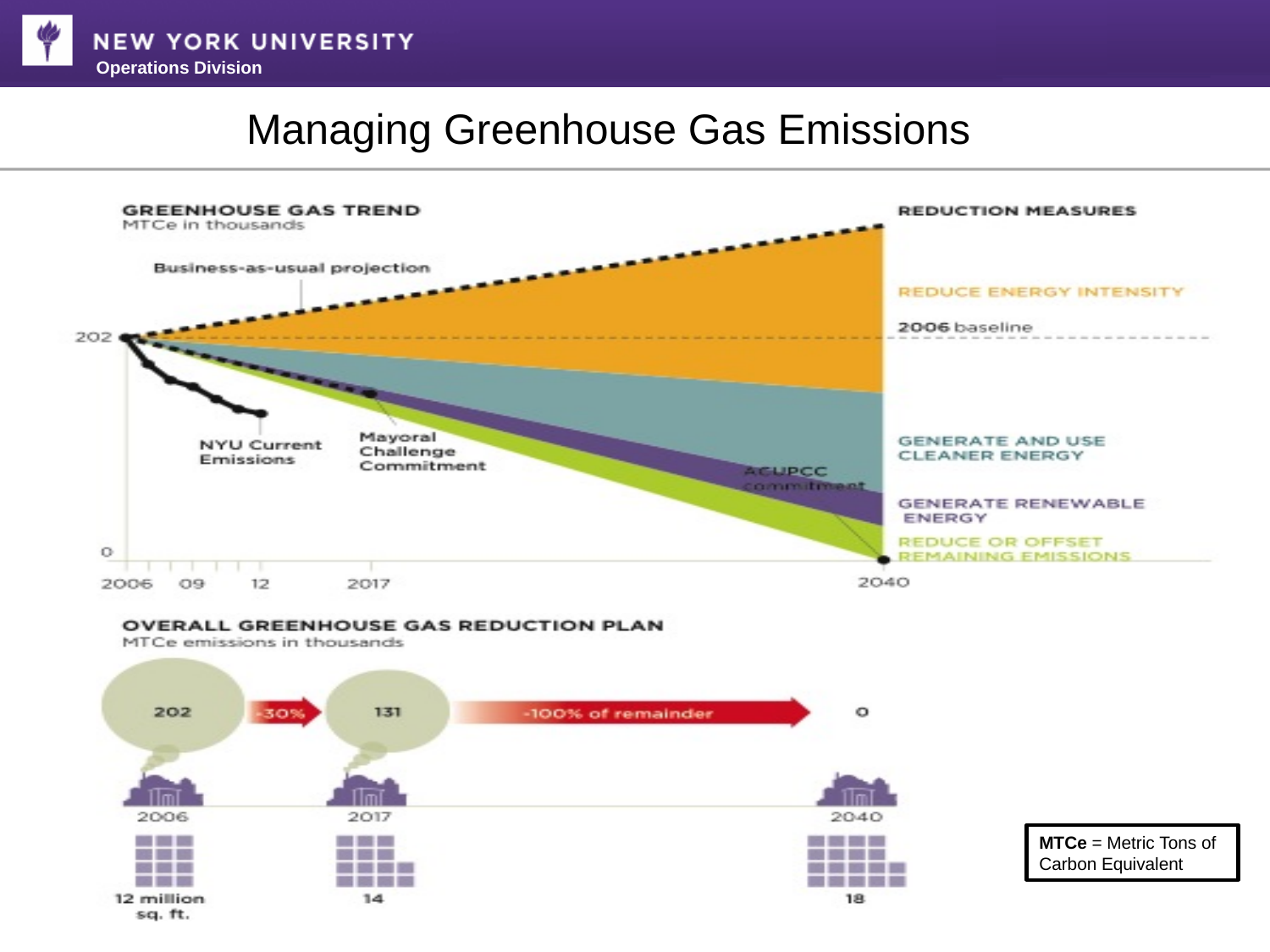
In the Overall Greenhouse Gas Reduction Plan chart, which year has the larger emissions value, 2006 or 2017? 2006 In the Overall Greenhouse Gas Reduction Plan chart, what percentage reduction is shown between 2006 and 2017? -30% In the Greenhouse Gas Trend chart, in what unit are the emissions measured? MTCe in thousands In the Greenhouse Gas Trend chart, does the NYU Current Emissions line rise or fall from 2006 to 2012? fall In the Greenhouse Gas Trend chart, does the Business-as-usual projection rise or fall from 2006 to 2040? rise In the Overall Greenhouse Gas Reduction Plan chart, what is the emissions value shown for 2006? 202 In the Greenhouse Gas Trend chart, how many reduction measures are listed on the right side? 4 In the Overall Greenhouse Gas Reduction Plan chart, what is the emissions value shown for 2017? 131 In the Overall Greenhouse Gas Reduction Plan chart, what is the difference between the 2006 and 2017 emissions values? 71 In the Overall Greenhouse Gas Reduction Plan chart, what is the emissions value shown for 2040? 0 In the Greenhouse Gas Trend chart, what is the value of the 2006 baseline? 202 In the Overall Greenhouse Gas Reduction Plan chart, how many million square feet are shown for 2040? 18